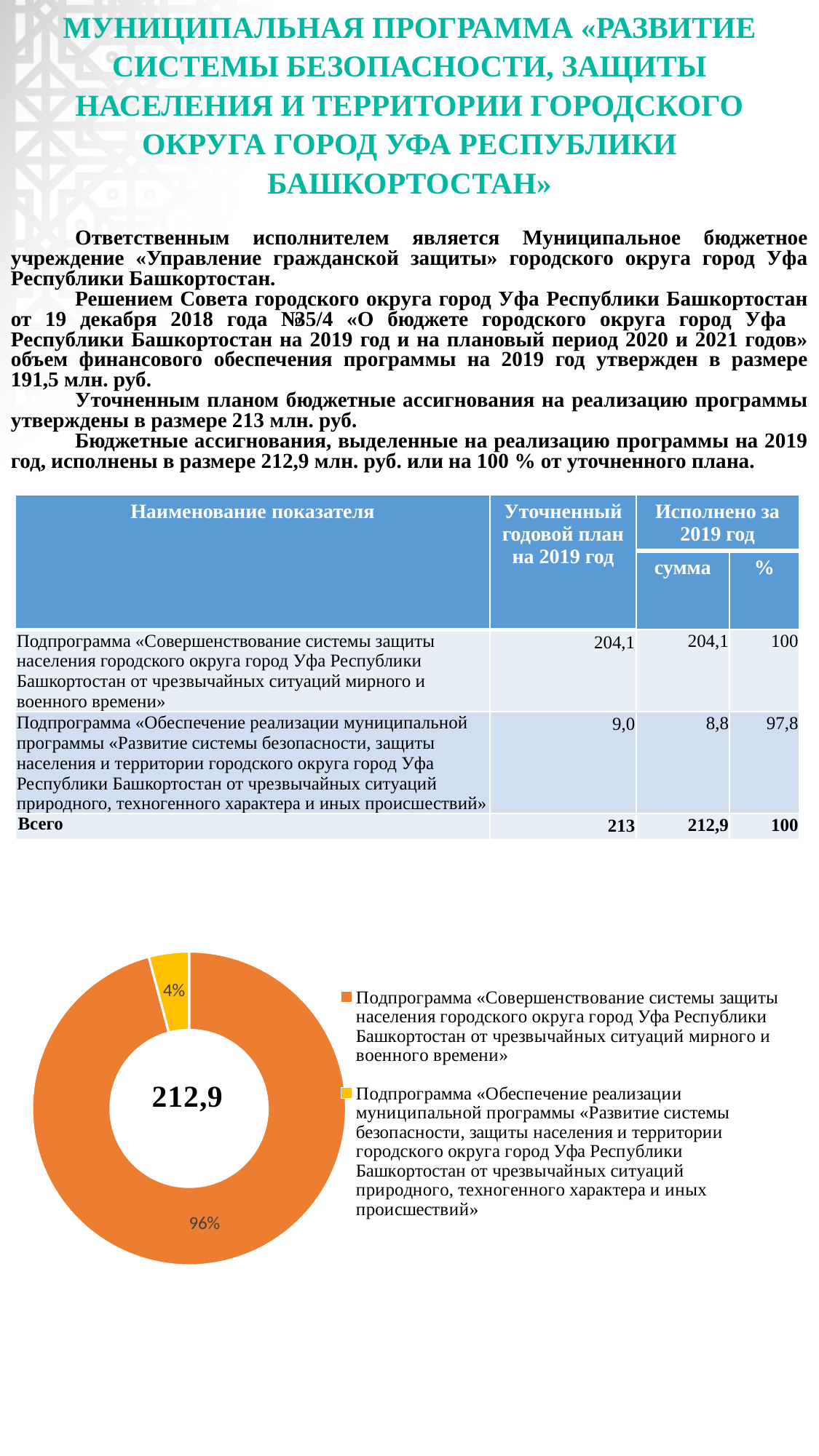
What colour is the slice representing the subprogram «Обеспечение реализации муниципальной программы...» in the doughnut chart? Yellow What number is printed in the centre of the doughnut chart? 212,9 How many slices does the doughnut chart have? 2 What share of the doughnut chart does the subprogram «Совершенствование системы защиты населения...» (orange slice) take? 96% What share of the doughnut chart does the subprogram «Обеспечение реализации муниципальной программы...» (yellow slice) take? 4% What kind of chart is shown at the bottom of the slide? Doughnut (pie) chart What is the difference in percentage points between the two slices of the doughnut chart? 92 Which slice of the doughnut chart is the largest? Подпрограмма «Совершенствование системы защиты населения городского округа город Уфа Республики Башкортостан от чрезвычайных ситуаций мирного и военного времени» Which slice is larger in the doughnut chart: the orange one or the yellow one? The orange one How many entries does the legend of the doughnut chart list? 2 Is the share of the orange slice in the doughnut chart greater or less than 50%? greater